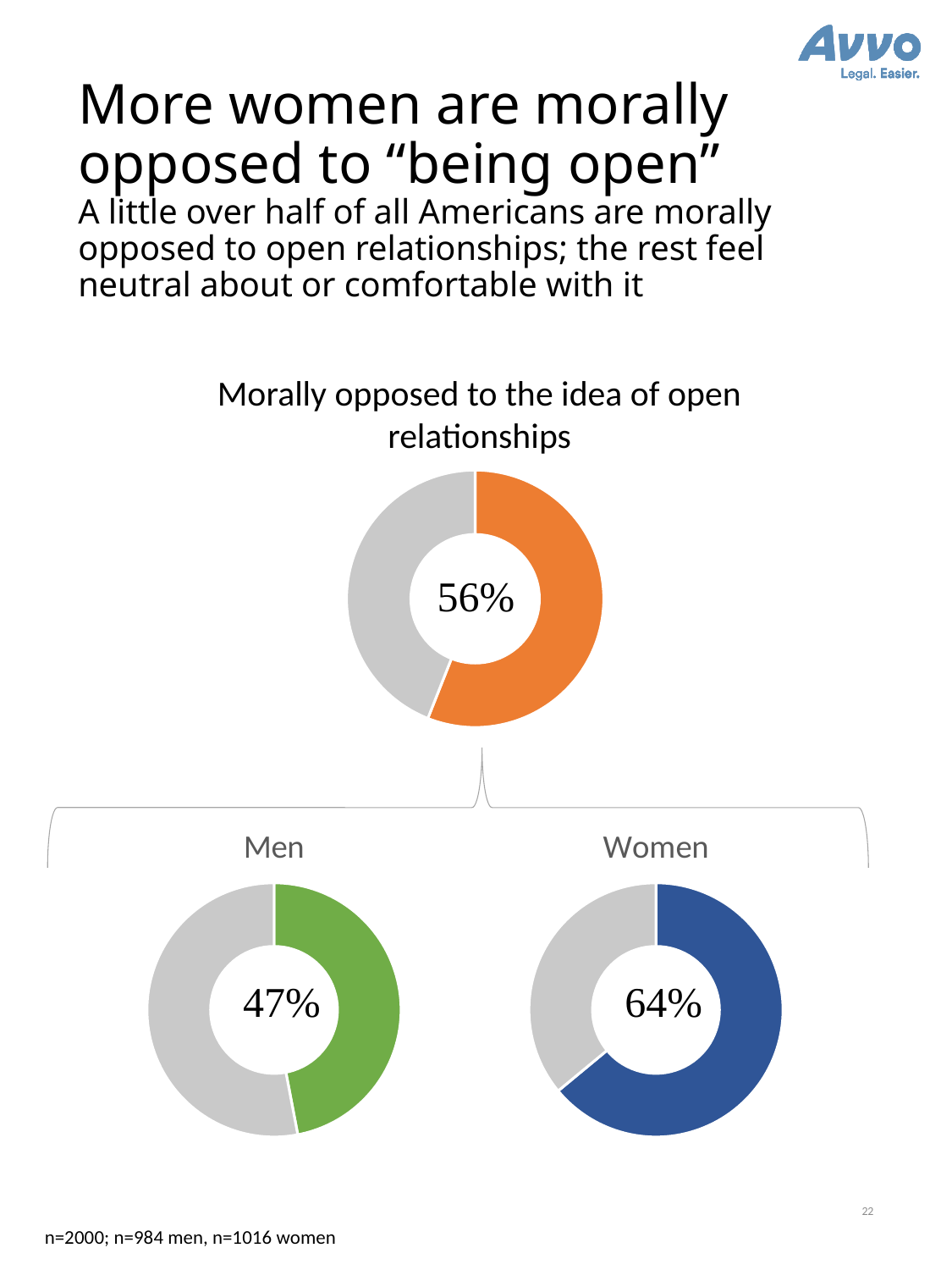
How many doughnut charts are shown on the slide? 3 Comparing the Men and Women doughnut charts, which group has the larger share morally opposed to open relationships? Women Of the three doughnut charts on the slide, which one shows the lowest percentage? Men What colour is the highlighted segment in the Women doughnut chart? Blue In the chart titled "Morally opposed to the idea of open relationships", what percentage is shown in the centre of the top doughnut chart? 56% In the Women doughnut chart, what percentage of women are morally opposed to the idea of open relationships? 64% What kind of chart is used to show the percentages on this slide? Doughnut chart Of the three doughnut charts on the slide, which one shows the highest percentage? Women In the Men doughnut chart, what percentage of men are morally opposed to the idea of open relationships? 47% What is the difference in percentage points between the Women chart value and the Men chart value? 17 percentage points Is the value shown in the Men doughnut chart greater or less than 50%? less What is the difference in percentage points between the overall chart value (56%) and the Men chart value (47%)? 9 percentage points